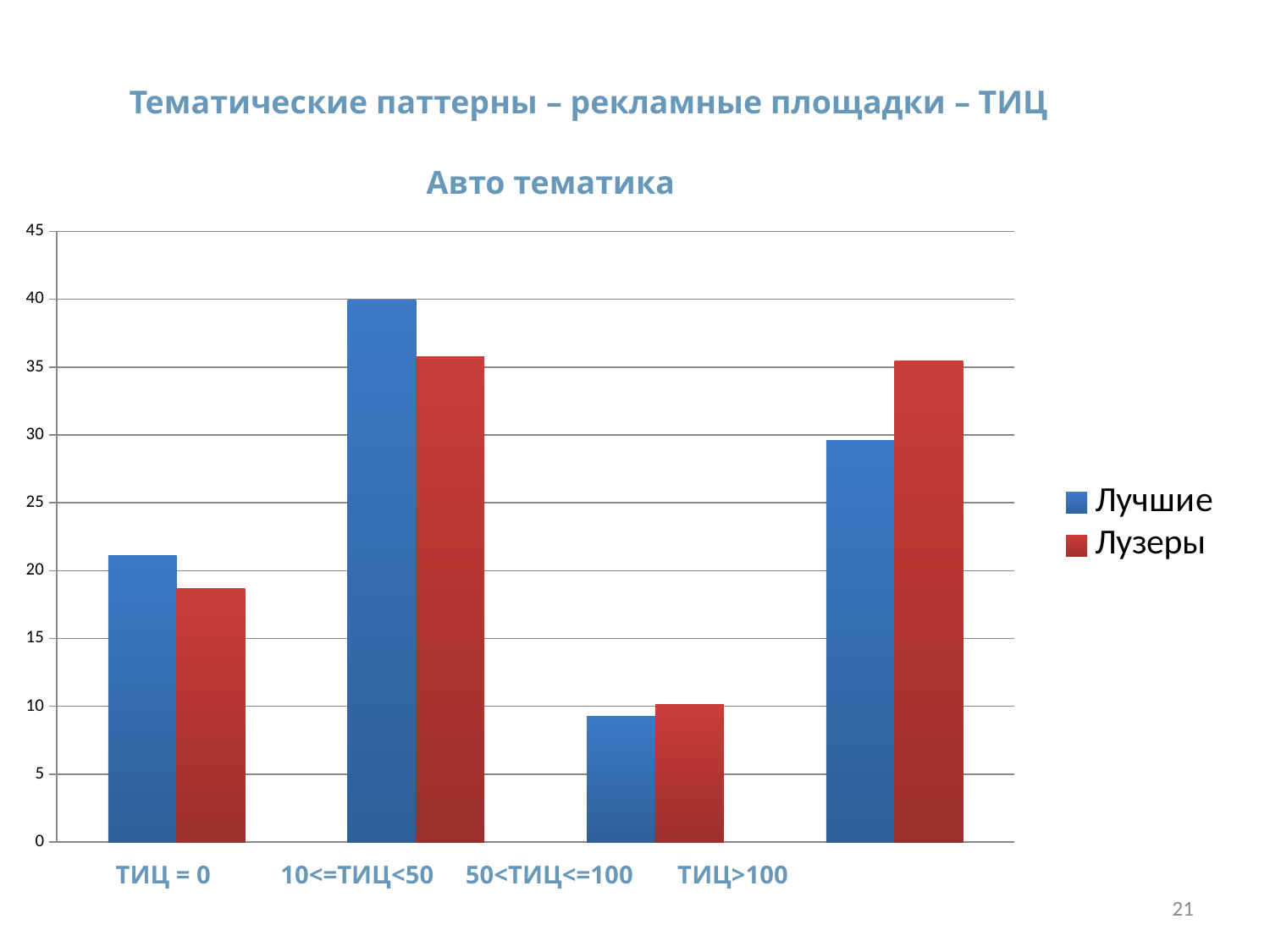
For the category 10<=ТИЦ<50, which series has the larger value, Лучшие or Лузеры? Лучшие How many series does the legend list? 2 What kind of chart is shown on the slide? bar chart For the category ТИЦ>100, which series has the larger value, Лучшие or Лузеры? Лузеры Which category has the lowest value for the Лучшие series? 50<ТИЦ<=100 For the category ТИЦ = 0, which series has the larger value, Лучшие or Лузеры? Лучшие Which category has the lowest value for the Лузеры series? 50<ТИЦ<=100 How many categories are shown on the x axis of the chart? 4 What is the title of the chart? Авто тематика Is the value for Лучшие in the category ТИЦ = 0 greater or less than 20? greater Which category has the highest value for the Лучшие series? 10<=ТИЦ<50 Is the value for Лучшие in the category 50<ТИЦ<=100 greater or less than 10? less